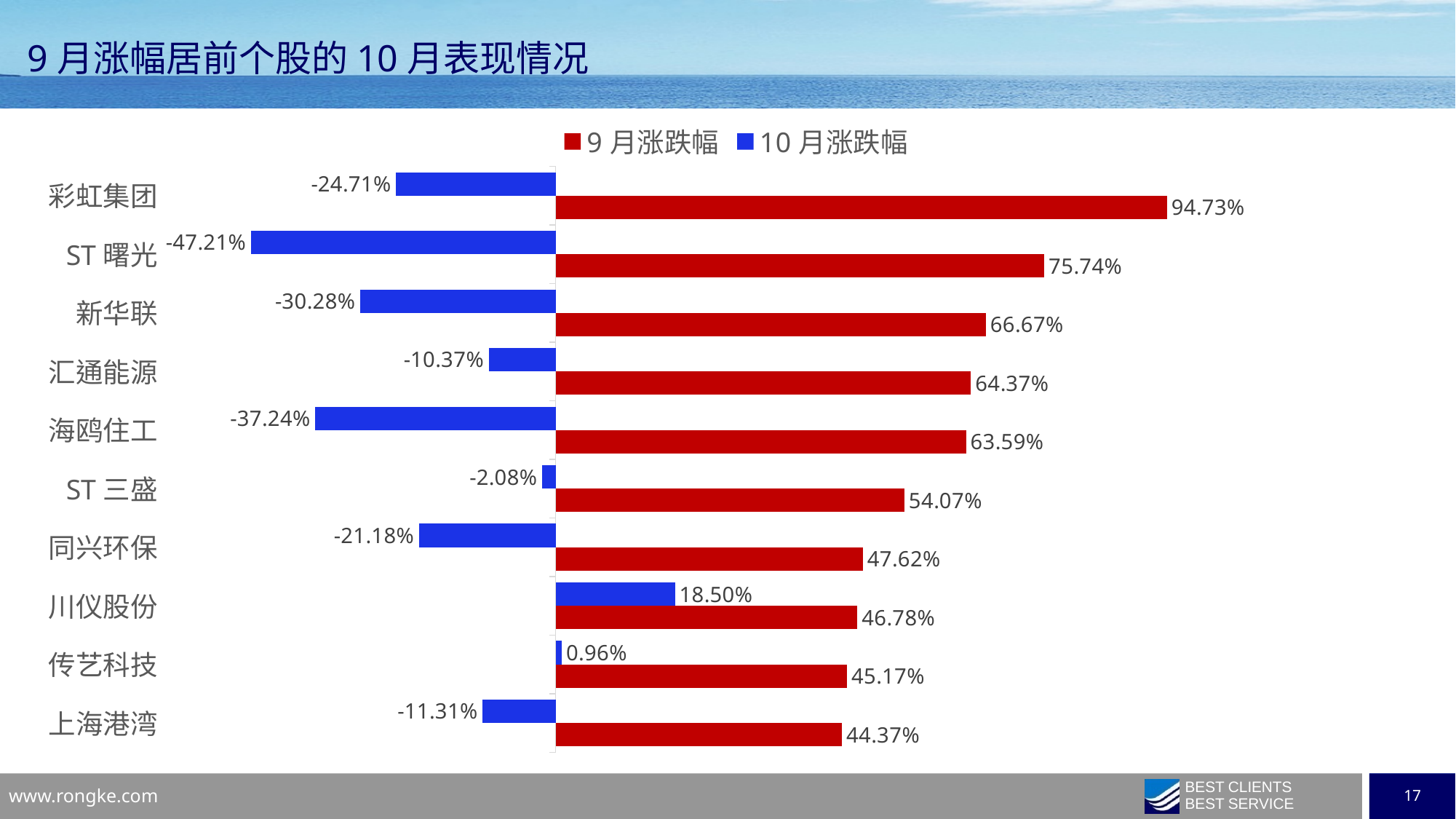
Which stock has the highest 9月涨跌幅? 彩虹集团 How many stocks are shown in the chart? 10 What is the 9月涨跌幅 value for 彩虹集团? 94.73% Which stock has the lowest 10月涨跌幅? ST曙光 Which stock has the highest 10月涨跌幅? 川仪股份 What kind of chart is shown on the slide? Bar chart What is the 10月涨跌幅 value for ST曙光? -47.21% What is the 10月涨跌幅 value for 川仪股份? 18.50% Which is larger, the 9月涨跌幅 for 汇通能源 or for 海鸥住工? 汇通能源 What is the difference between the 9月涨跌幅 and 10月涨跌幅 for 新华联? 96.95% How many series does the legend list? 2 What is the 9月涨跌幅 value for 上海港湾? 44.37%